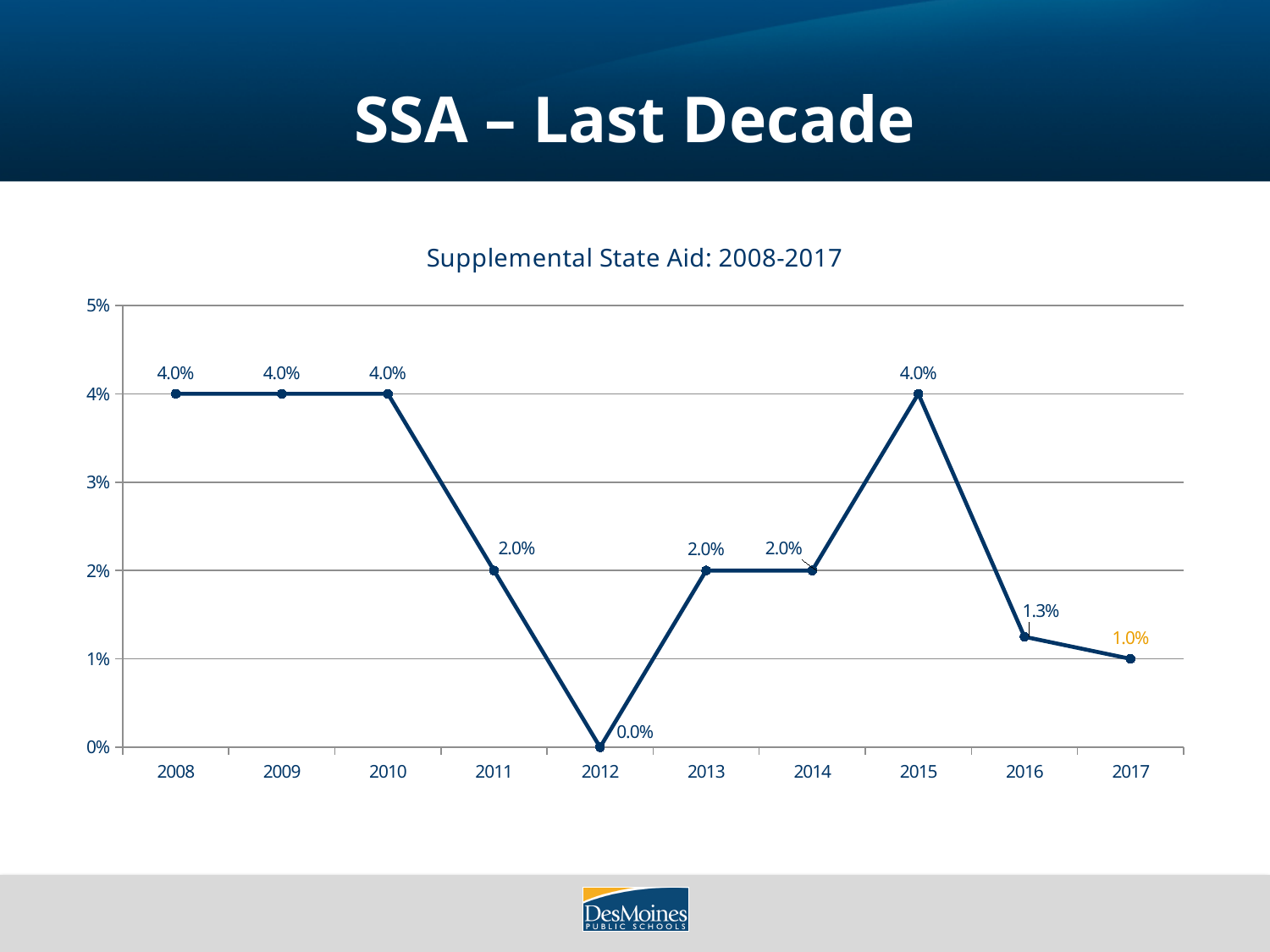
Which is larger, the Supplemental State Aid value for 2014 or for 2015? 2015 What is the Supplemental State Aid value for 2016? 1.3% What is the difference between the Supplemental State Aid values for 2015 and 2016? 2.7% What is the difference between the Supplemental State Aid values for 2010 and 2011? 2.0% What kind of chart is shown on the slide? line chart What is the Supplemental State Aid value for 2011? 2.0% How many years are plotted on the chart? 10 Which year has the lowest Supplemental State Aid value? 2012 Is the Supplemental State Aid value for 2016 greater or less than 2%? less What is the Supplemental State Aid value for 2012? 0.0% What is the Supplemental State Aid value for 2017? 1.0% What is the title of the chart? Supplemental State Aid: 2008-2017